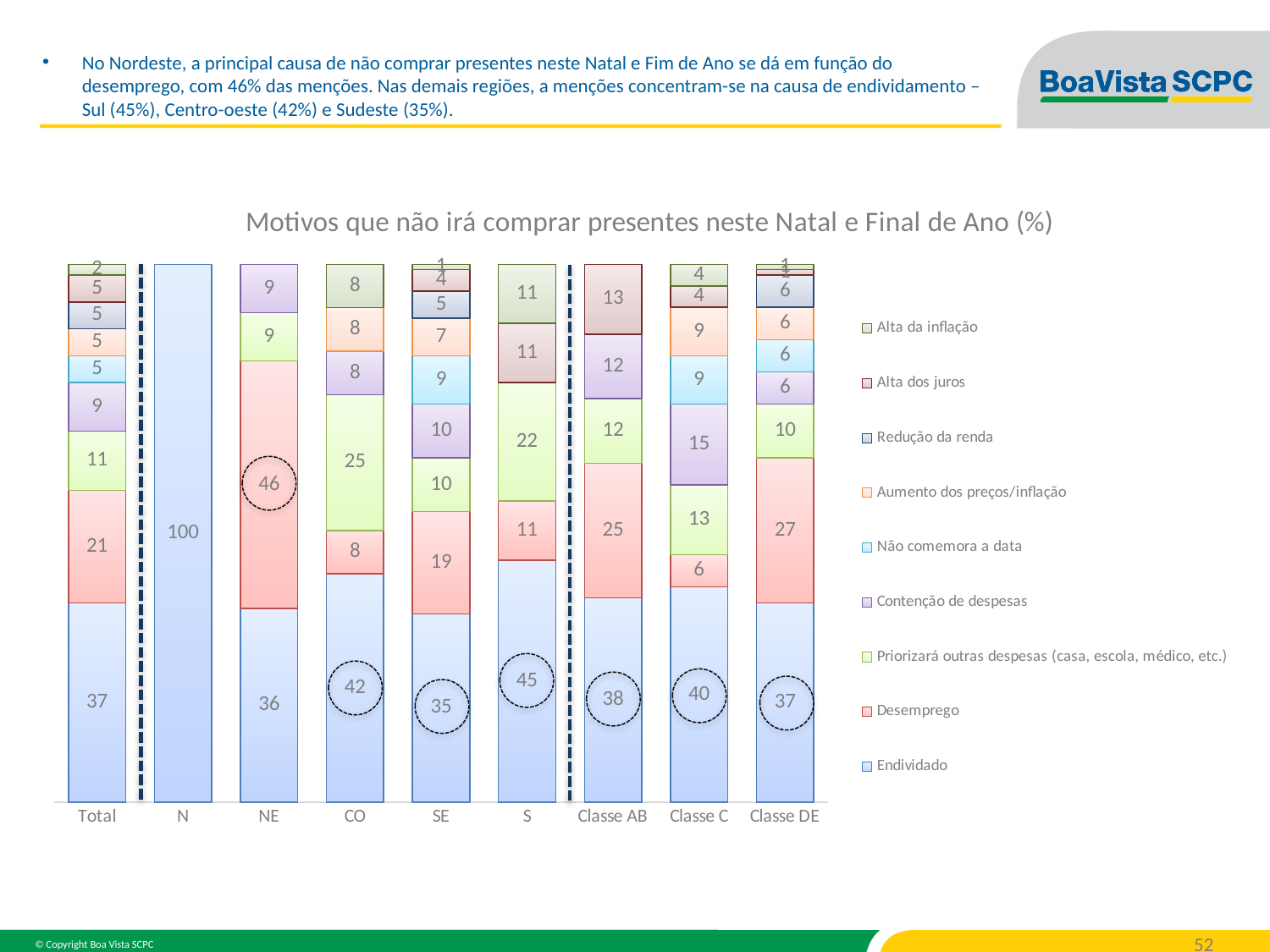
How many categories are shown on the x axis? 9 What is the title of the chart? Motivos que não irá comprar presentes neste Natal e Final de Ano (%) Which category has the lowest value for Desemprego among those showing a Desemprego segment? Classe C How many series does the legend list? 9 What is the difference between the Endividado values for S and SE? 10 What is the value for Endividado in the Classe C bar? 40 Which category has the highest value for Desemprego? NE Which is larger, the Desemprego value for Classe AB or for Classe DE? Classe DE What kind of chart is shown on the slide? Stacked bar chart Which category has the highest value for Endividado? N What is the value for Desemprego in the NE bar? 46 What is the value for Priorizará outras despesas in the CO bar? 25